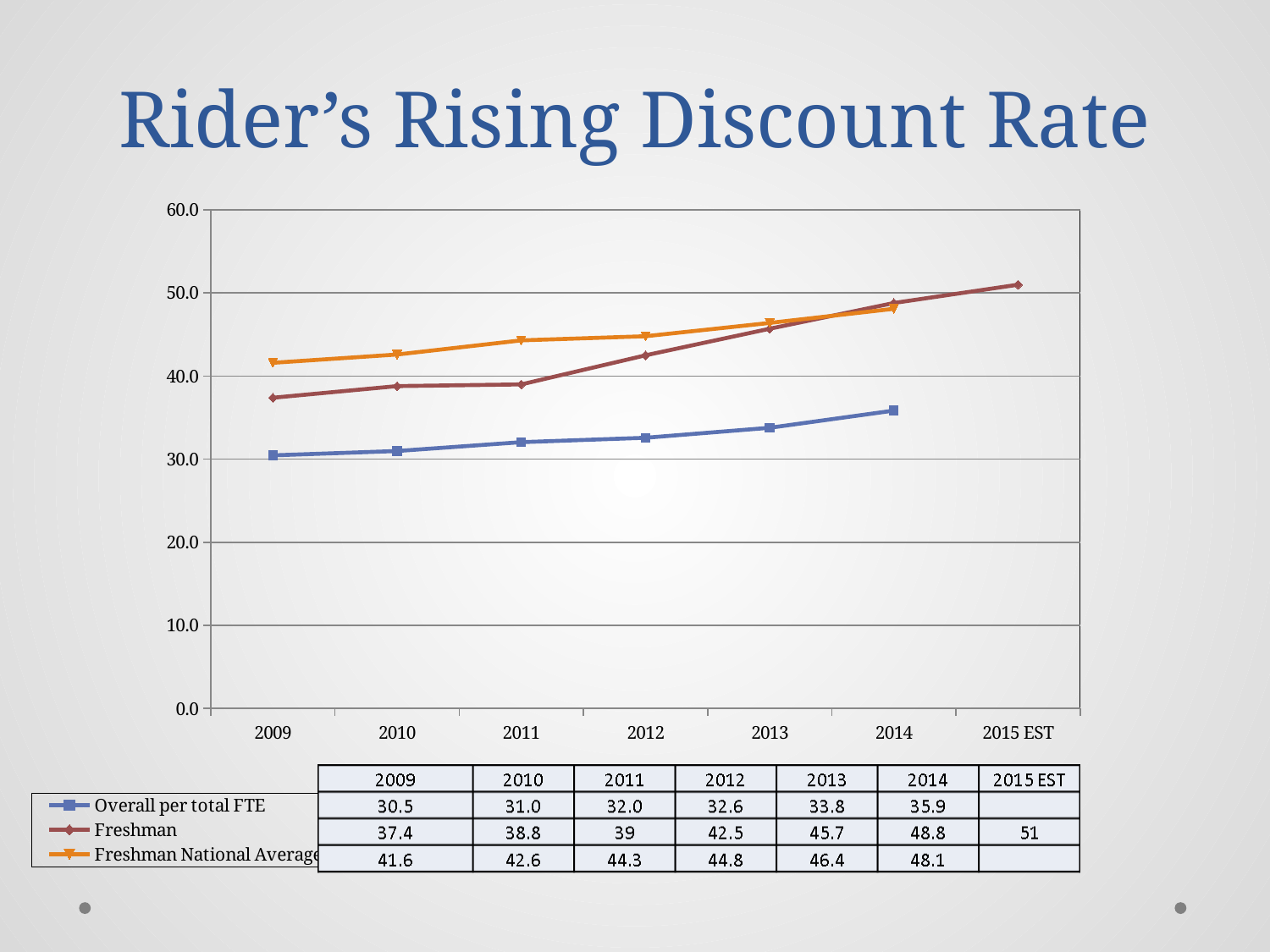
Which is larger in 2014, the Freshman value or the Freshman National Average value? Freshman What is the Freshman National Average value for 2011? 44.3 How many series does the legend list? 3 What is the Freshman value for 2015 EST? 51 What is the Freshman value for 2013? 45.7 Does the Overall per total FTE series rise or fall from 2009 to 2014? rise What is the difference between the Freshman value and the Overall per total FTE value in 2012? 9.9 In which year is the Freshman National Average value highest? 2014 What type of chart is shown on the slide? line chart In which year is the Overall per total FTE value lowest? 2009 What is the Overall per total FTE value for 2014? 35.9 What is the title of the chart? Rider's Rising Discount Rate